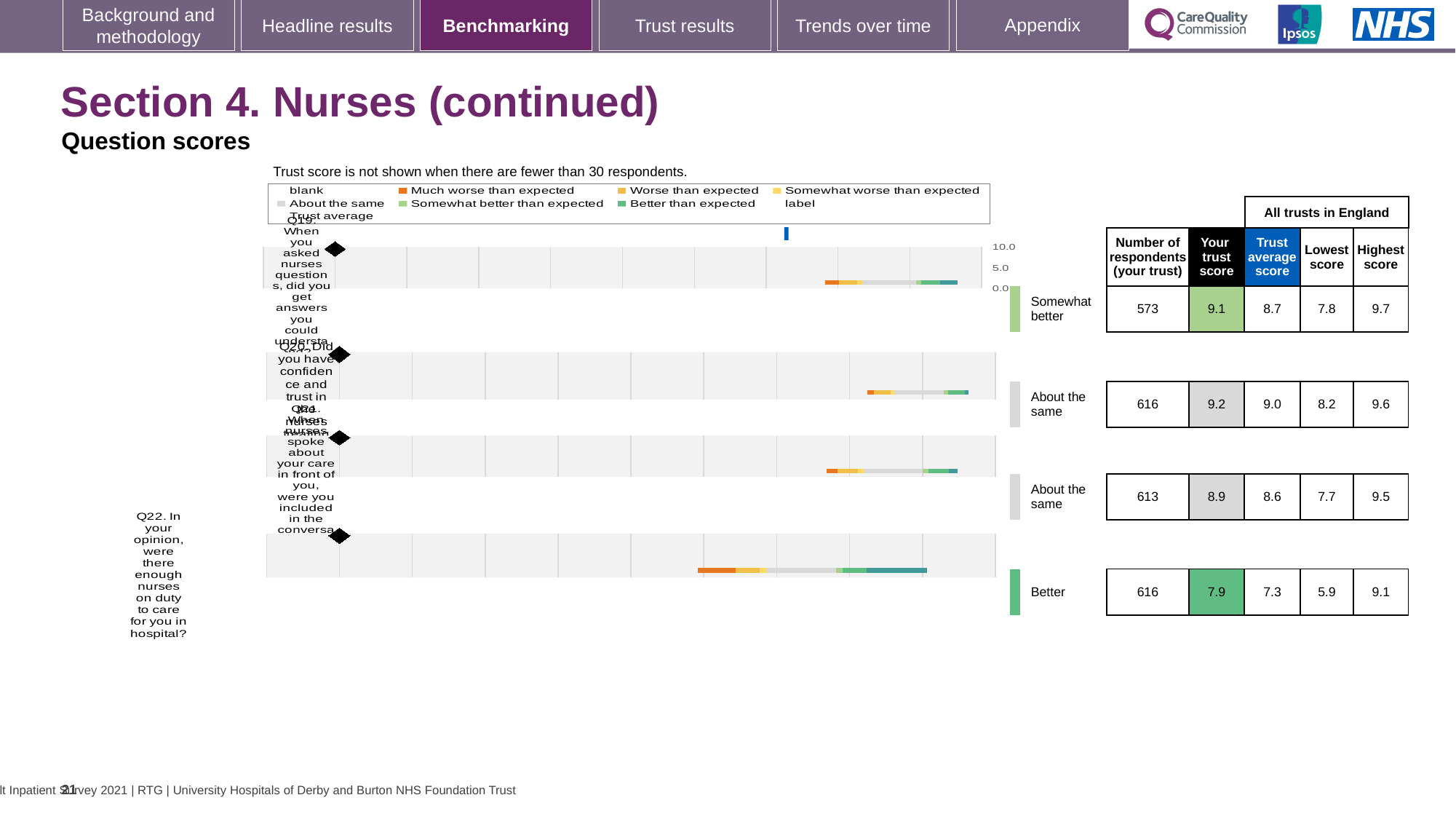
Which question has the lowest 'Your trust score'? Q22 For Q22, how much higher is your trust score than the trust average score? 0.6 What is the lowest score across all trusts in England for Q22? 5.9 What kind of chart is used to show the question scores? Bar chart What is the 'Your trust score' for Q19 (When you asked nurses questions, did you get answers you could understand)? 9.1 Which has the higher 'Your trust score', Q19 or Q21? Q19 How many questions are plotted in the chart? 4 What is the highest score across all trusts in England for Q20 (Did you have confidence and trust in the nurses treating you)? 9.6 How many respondents from your trust answered Q21? 613 Which question has the highest 'Your trust score'? Q20 What benchmark category is shown for Q22? Better What is the trust average score for Q22 (were there enough nurses on duty to care for you in hospital)? 7.3